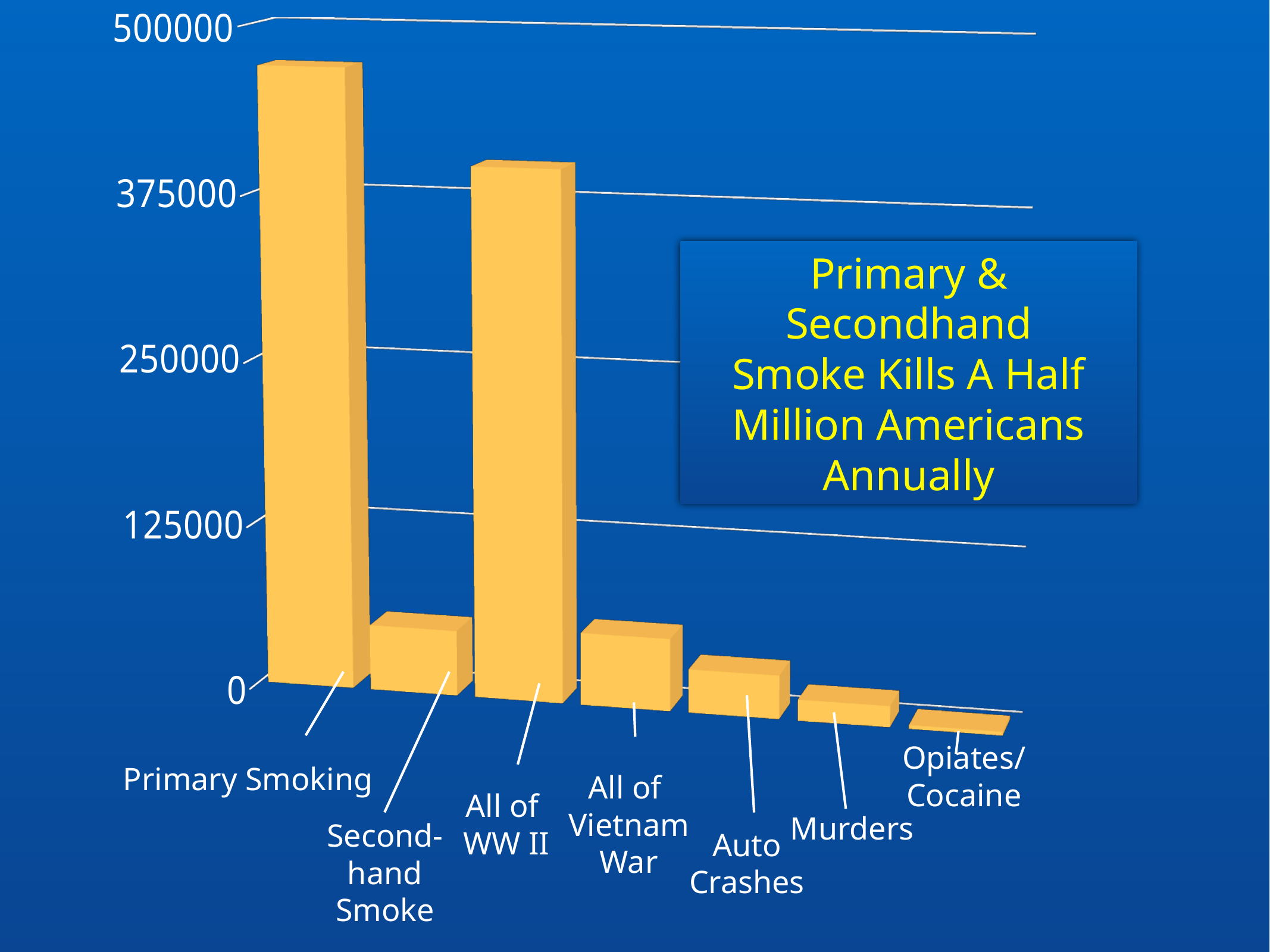
Which is larger, the value for Auto Crashes or the value for Murders? Auto Crashes What kind of chart is shown on the slide? bar chart Is the value for Primary Smoking greater or less than 375000? greater Is the value for All of WW II greater or less than 250000? greater What does the text box on the chart say? Primary & Secondhand Smoke Kills A Half Million Americans Annually How many categories are plotted in the bar chart? 7 Is the value for Primary Smoking greater or less than 500000? less Which is larger, the value for Primary Smoking or the value for All of WW II? Primary Smoking Which category has the lowest value in the chart? Opiates/Cocaine Which category has the highest value in the chart? Primary Smoking